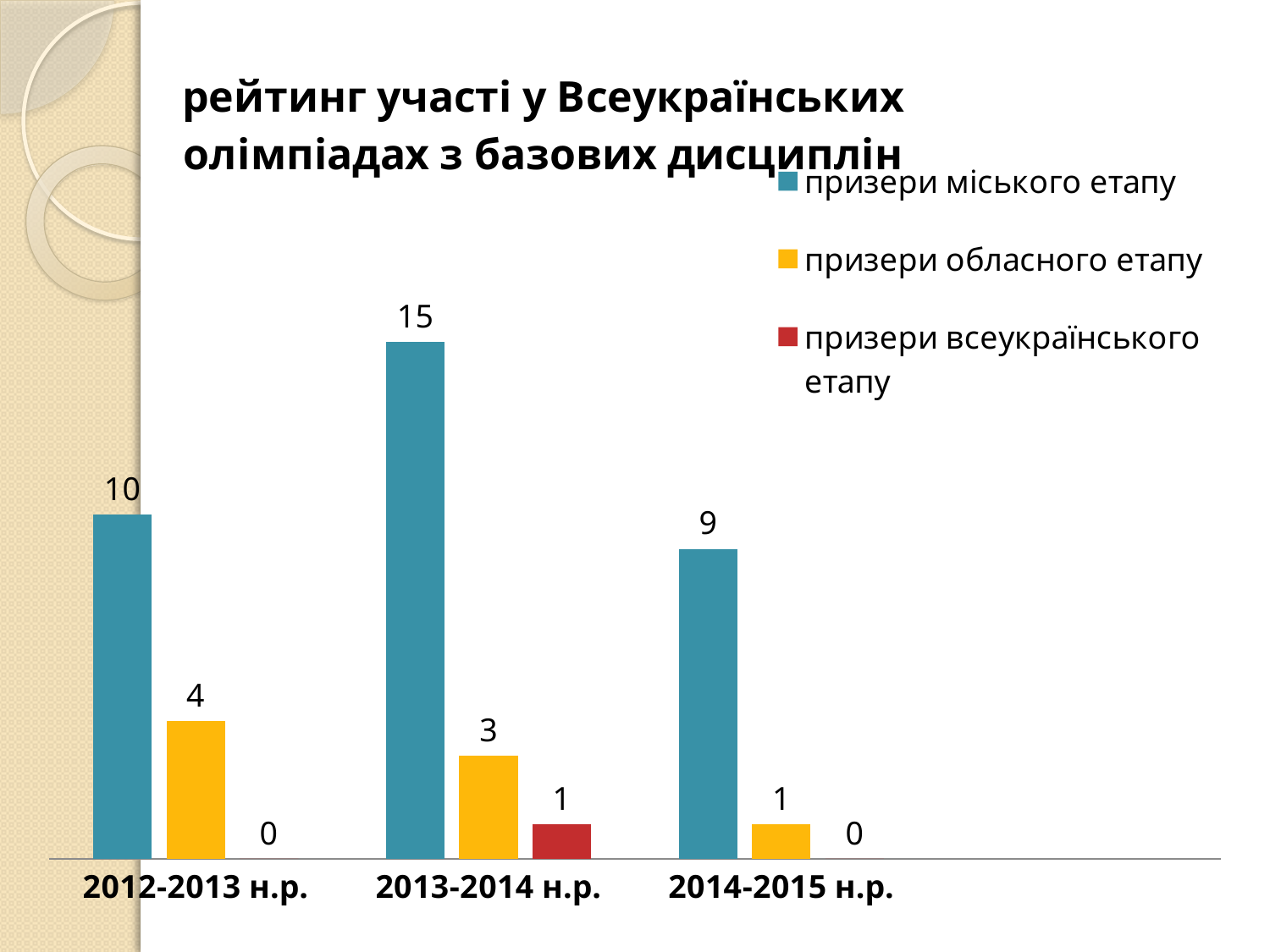
What type of chart is shown on the slide? bar chart Which colour represents призери всеукраїнського етапу in the legend? red What is the difference between призери міського етапу in 2013-2014 н.р. and in 2012-2013 н.р.? 5 What is the value for призери всеукраїнського етапу in 2014-2015 н.р.? 0 How many series does the legend list? 3 In which school year is the value for призери міського етапу lowest? 2014-2015 н.р. What is the value for призери обласного етапу in 2012-2013 н.р.? 4 What is the value for призери міського етапу in 2013-2014 н.р.? 15 Which is larger: призери обласного етапу in 2012-2013 н.р. or in 2013-2014 н.р.? 2012-2013 н.р. How many categories (school years) are shown on the x axis? 3 Does the value for призери обласного етапу rise or fall from 2012-2013 н.р. to 2014-2015 н.р.? fall In which school year is the value for призери міського етапу highest? 2013-2014 н.р.